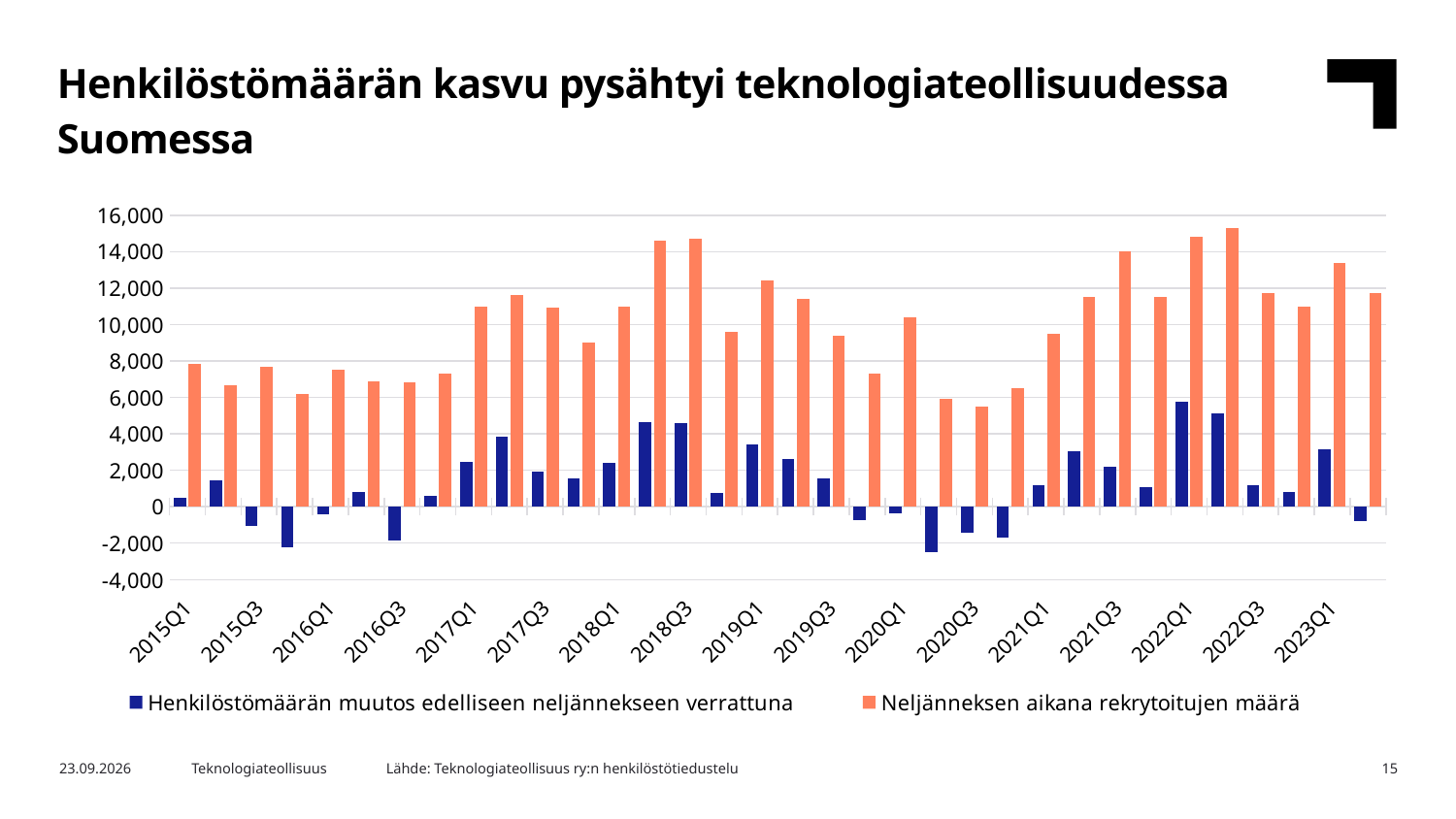
Which series is shown in orange according to the legend? Neljänneksen aikana rekrytoitujen määrä Which quarter has the highest value of 'Henkilöstömäärän muutos edelliseen neljännekseen verrattuna'? 2022Q1 Which is larger for 'Henkilöstömäärän muutos edelliseen neljännekseen verrattuna': 2019Q1 or 2020Q3? 2019Q1 Is the value of 'Neljänneksen aikana rekrytoitujen määrä' for 2015Q1 greater or less than 10,000? less Which is larger for 'Neljänneksen aikana rekrytoitujen määrä': 2018Q3 or 2020Q3? 2018Q3 Is the value of 'Henkilöstömäärän muutos edelliseen neljännekseen verrattuna' for 2022Q1 greater or less than 4,000? greater How many series does the legend list? 2 Is the value of 'Neljänneksen aikana rekrytoitujen määrä' for 2020Q3 greater or less than 6,000? less Does the value of 'Neljänneksen aikana rekrytoitujen määrä' rise or fall from 2016Q3 to 2017Q3? rise What kind of chart is shown on the slide? bar chart